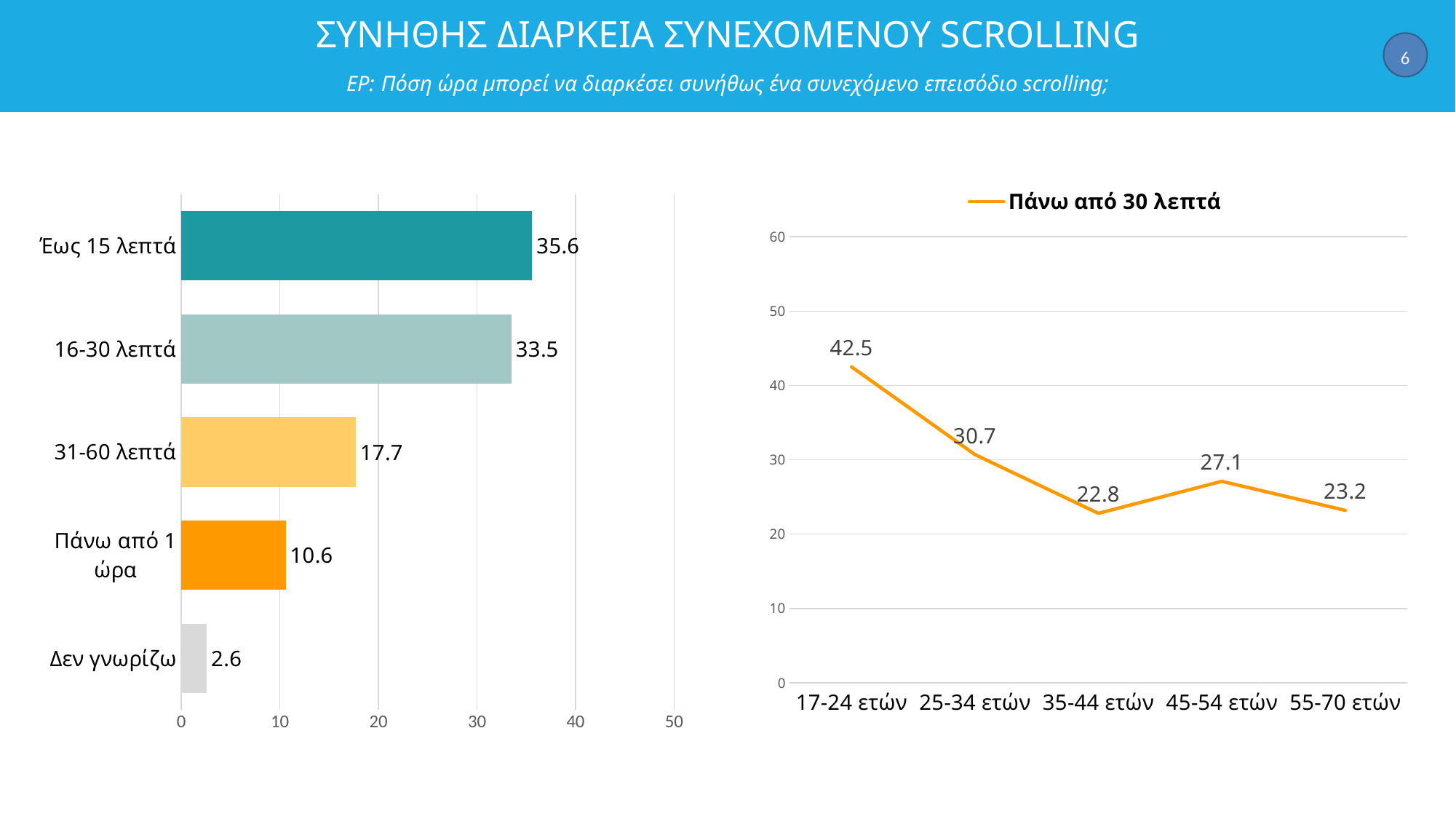
What kind of chart is the chart on the left? Bar chart In the line chart on the right, what is the value for '45-54 ετών'? 27.1 In the line chart on the right, which age group has the lowest value? 35-44 ετών In the bar chart on the left, which category has the lowest value? Δεν γνωρίζω In the bar chart on the left, what is the value for 'Πάνω από 1 ώρα'? 10.6 In the bar chart on the left, what is the difference between the values for '16-30 λεπτά' and '31-60 λεπτά'? 15.8 In the bar chart on the left, what is the value for 'Έως 15 λεπτά'? 35.6 In the line chart on the right, what is the value for '17-24 ετών'? 42.5 In the bar chart on the left, how many categories are shown? 5 What is the legend entry of the line chart on the right? Πάνω από 30 λεπτά In the bar chart on the left, which category has the highest value? Έως 15 λεπτά In the line chart on the right, what is the difference between the values for '17-24 ετών' and '25-34 ετών'? 11.8